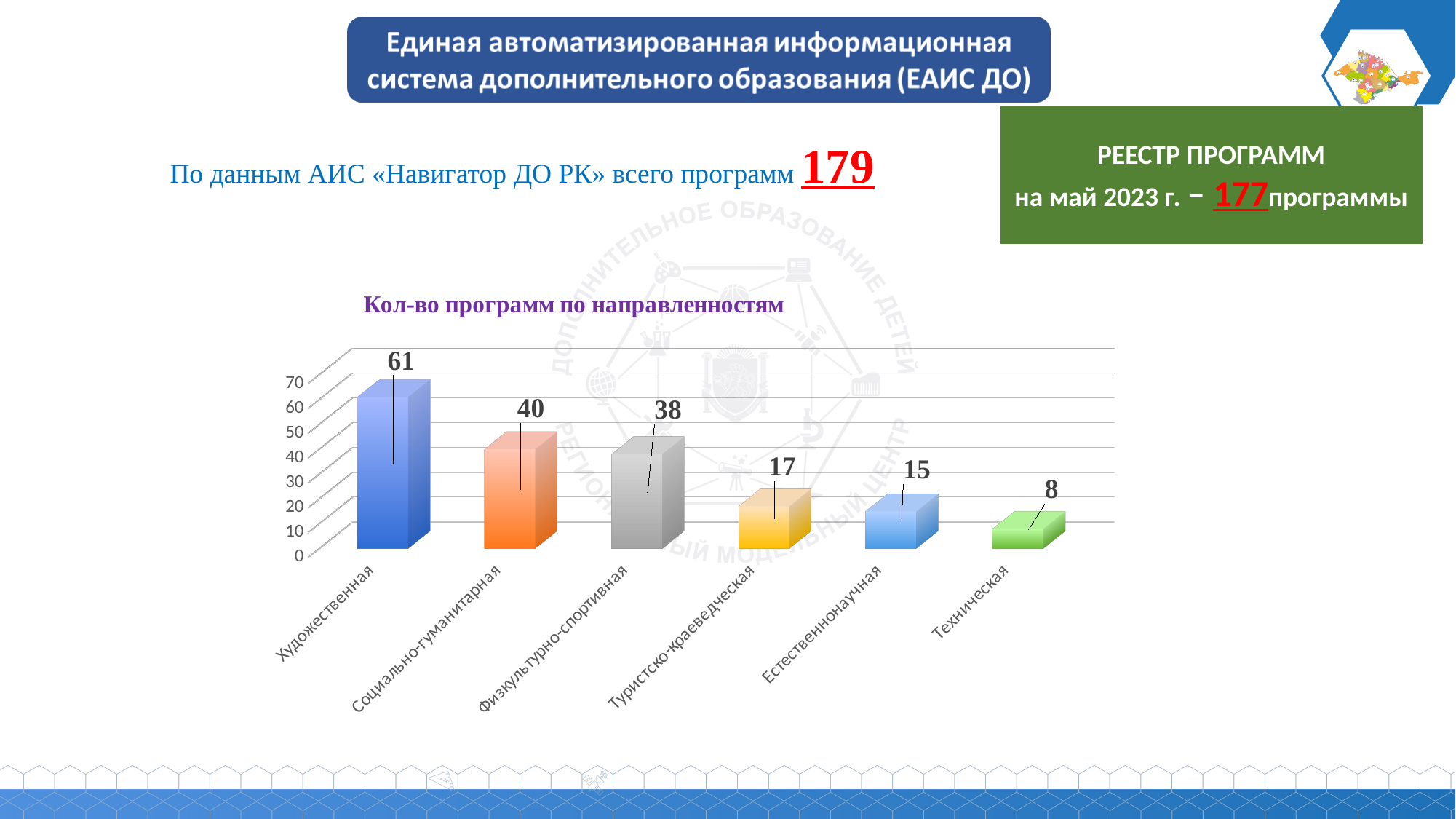
What is the difference between the values for Художественная and Социально-гуманитарная? 21 What is the title of the chart? Кол-во программ по направленностям Which category has the highest value? Художественная Is the value for Физкультурно-спортивная greater or less than 30? greater Which is larger, the value for Физкультурно-спортивная or the value for Естественнонаучная? Физкультурно-спортивная How many categories are shown in the chart? 6 What is the value for Художественная? 61 What is the value for Техническая? 8 What is the value for Социально-гуманитарная? 40 What is the value for Туристско-краеведческая? 17 Which category has the lowest value? Техническая What kind of chart is shown on the slide? bar chart